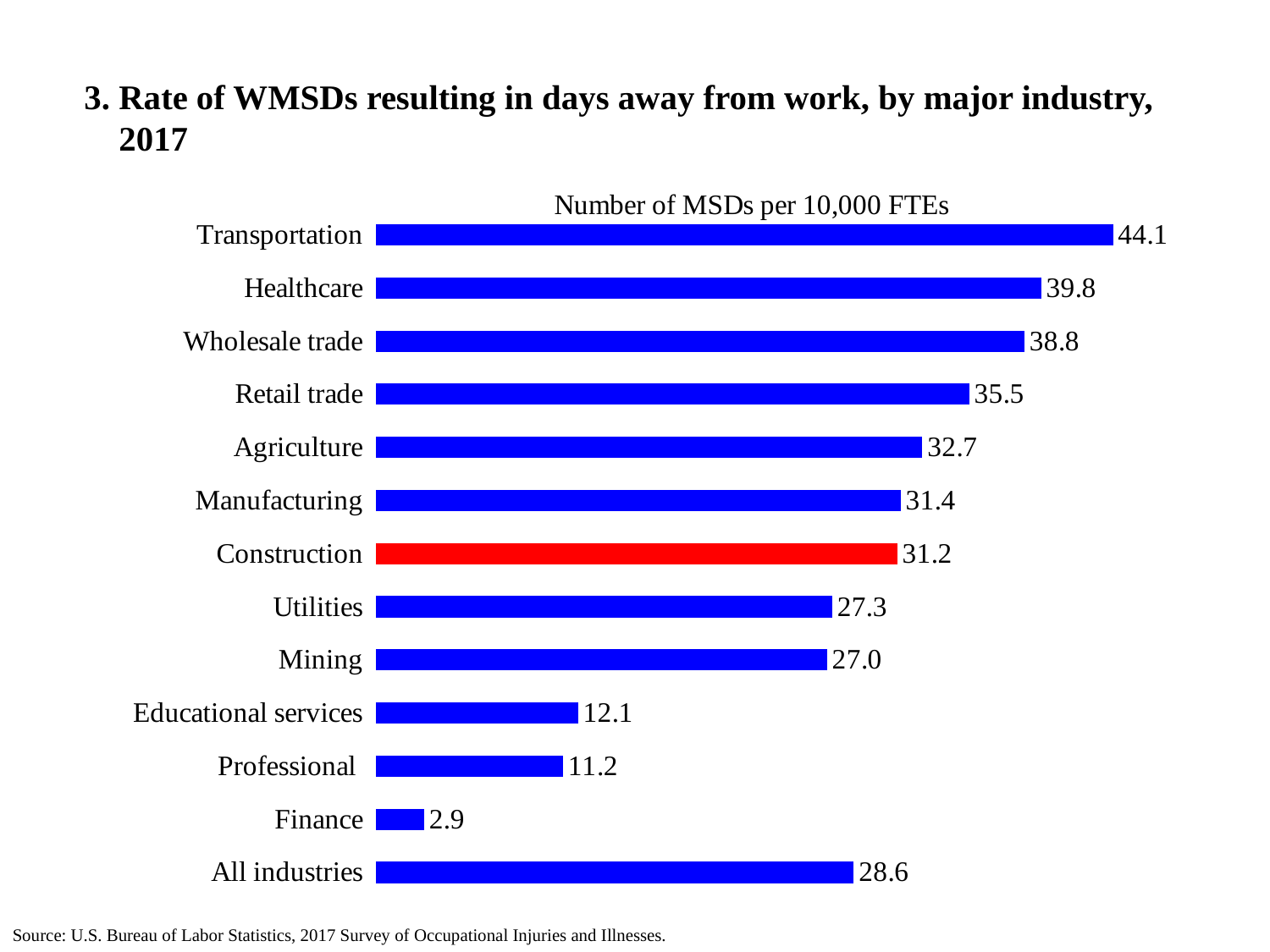
Which industry has the highest rate of MSDs per 10,000 FTEs? Transportation Which has a higher value, Retail trade or Agriculture? Retail trade What is the number of MSDs per 10,000 FTEs for Construction? 31.2 Which has a higher value, Educational services or Professional? Educational services How many industry categories are shown in the chart? 13 What is the value shown for All industries? 28.6 Which industry has the lowest rate of MSDs per 10,000 FTEs? Finance Which bar is coloured red instead of blue? Construction What is the difference between the values for Construction and All industries? 2.6 What is the value shown for Healthcare? 39.8 What type of chart is shown on the slide? Bar chart What is the difference between the values for Transportation and Construction? 12.9